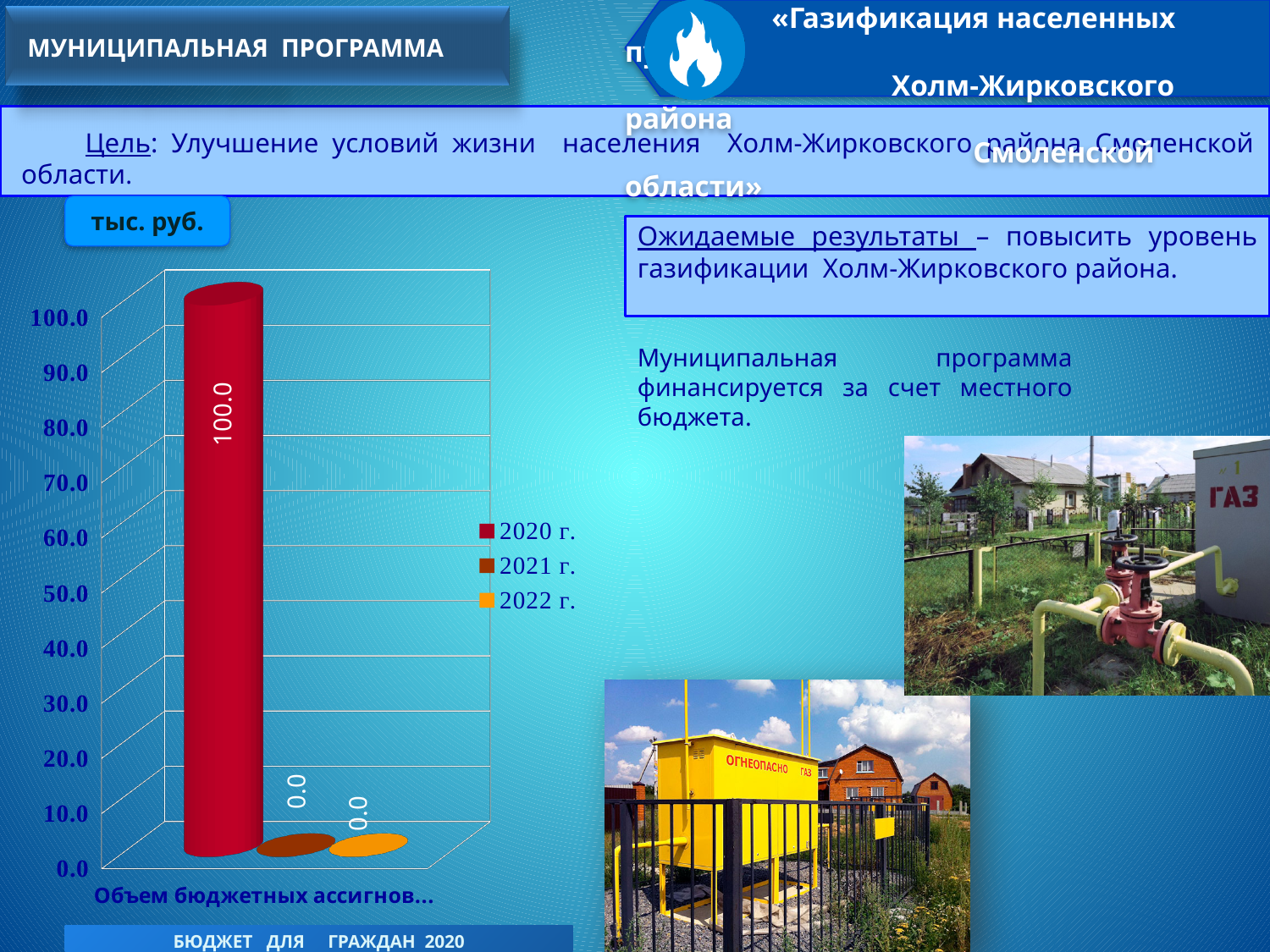
Is the value for 2020 г. greater or less than 90.0? greater What colour is the bar for 2020 г. in the chart? red What unit is shown in the label above the chart? тыс. руб. What kind of chart is shown on the slide? bar chart Which year has the highest value in the chart? 2020 г. What is the value for 2022 г. in the chart? 0.0 What is the value for 2021 г. in the chart? 0.0 Do the values rise or fall from 2020 г. to 2022 г.? fall How many series does the chart legend list? 3 Which is larger, the value for 2020 г. or the value for 2022 г.? 2020 г. What is the difference between the values for 2020 г. and 2021 г.? 100.0 What is the value for 2020 г. in the chart? 100.0